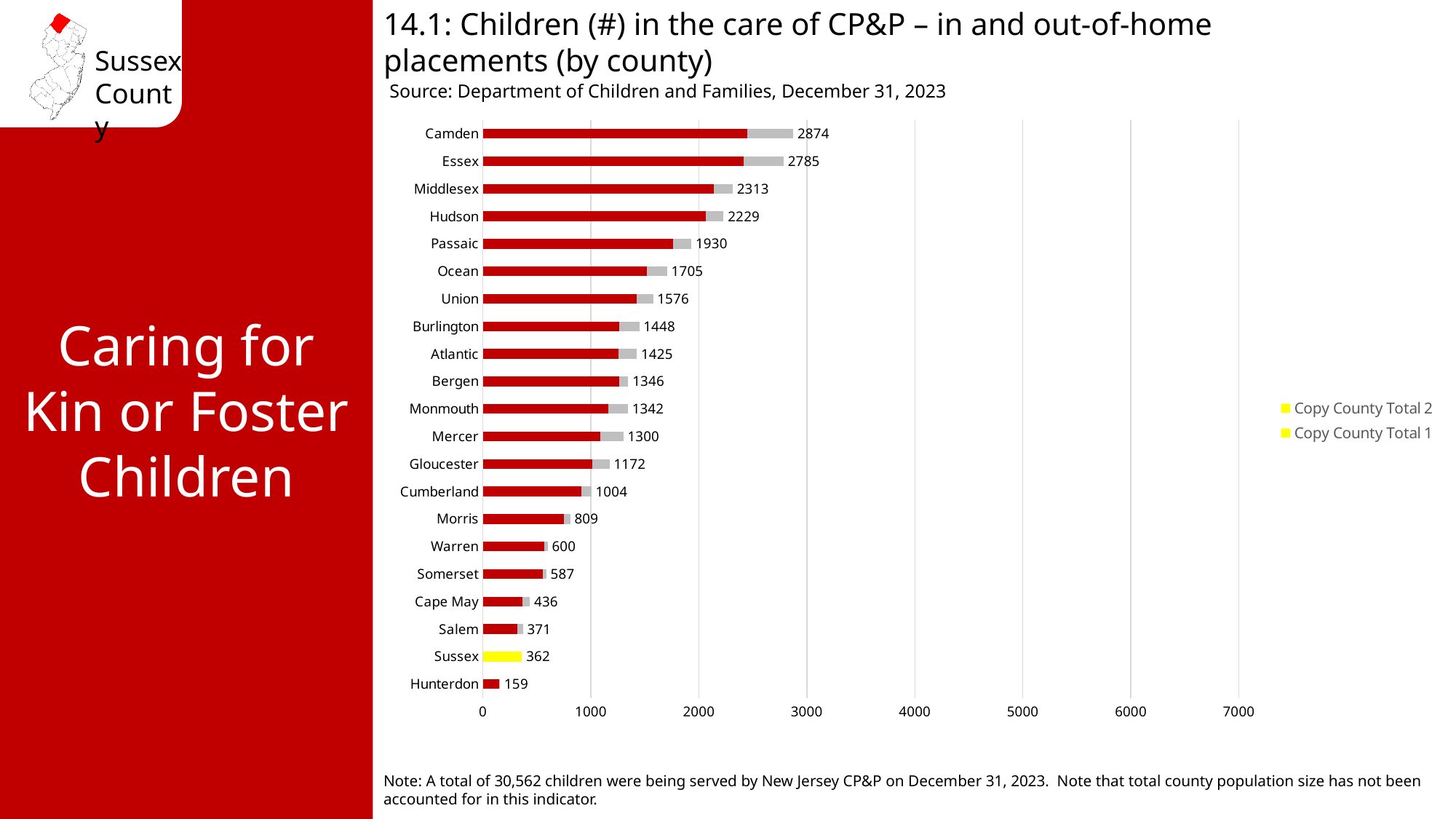
What kind of chart is shown on the slide? Bar chart What value is labelled for Sussex County? 362 Which has a larger labelled total, Ocean or Union? Ocean Which county has the highest labelled total? Camden What value is labelled for Passaic? 1930 What is the difference between the labelled totals for Camden and Essex? 89 Is the labelled total for Middlesex greater or less than 2000? greater How many counties are listed on the chart? 21 How many entries does the legend list? 2 Which county has the lowest labelled total? Hunterdon What is the total number of children in the care of CP&P shown for Camden? 2874 What is the difference between the labelled totals for Salem and Sussex? 9